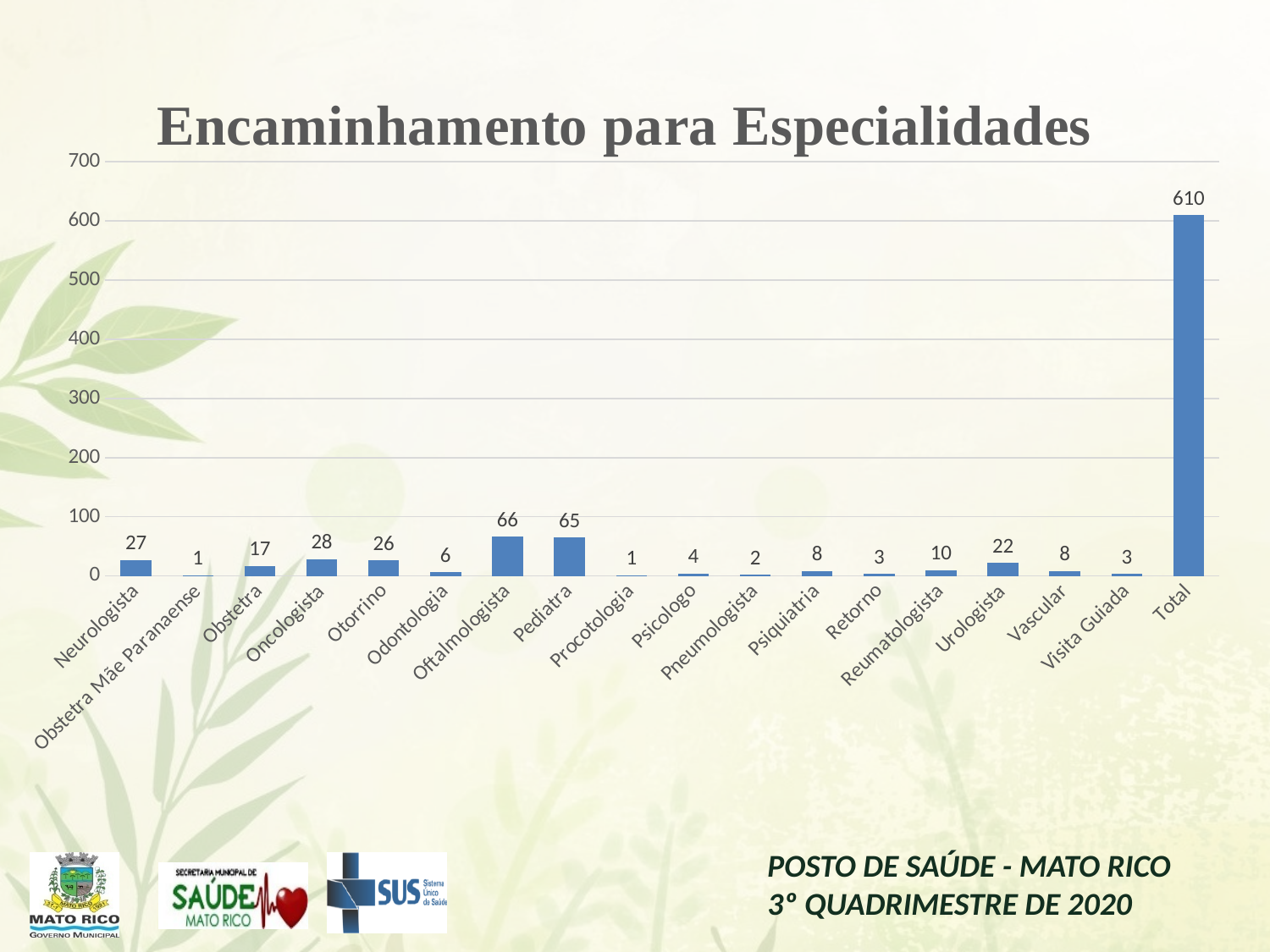
Which is larger, the value for Oncologista or the value for Otorrino? Oncologista What is the value for Oftalmologista? 66 What is the value for Neurologista? 27 How many categories are shown on the x axis? 18 What is the value for Urologista? 22 What is the title of the chart? Encaminhamento para Especialidades What is the difference between the values for Oncologista and Obstetra? 11 What is the value shown for the Total bar? 610 Is the value for Total greater or less than 600? greater What kind of chart is shown on the slide? bar chart Which category has the highest bar? Total What is the difference between the values for Oftalmologista and Pediatra? 1